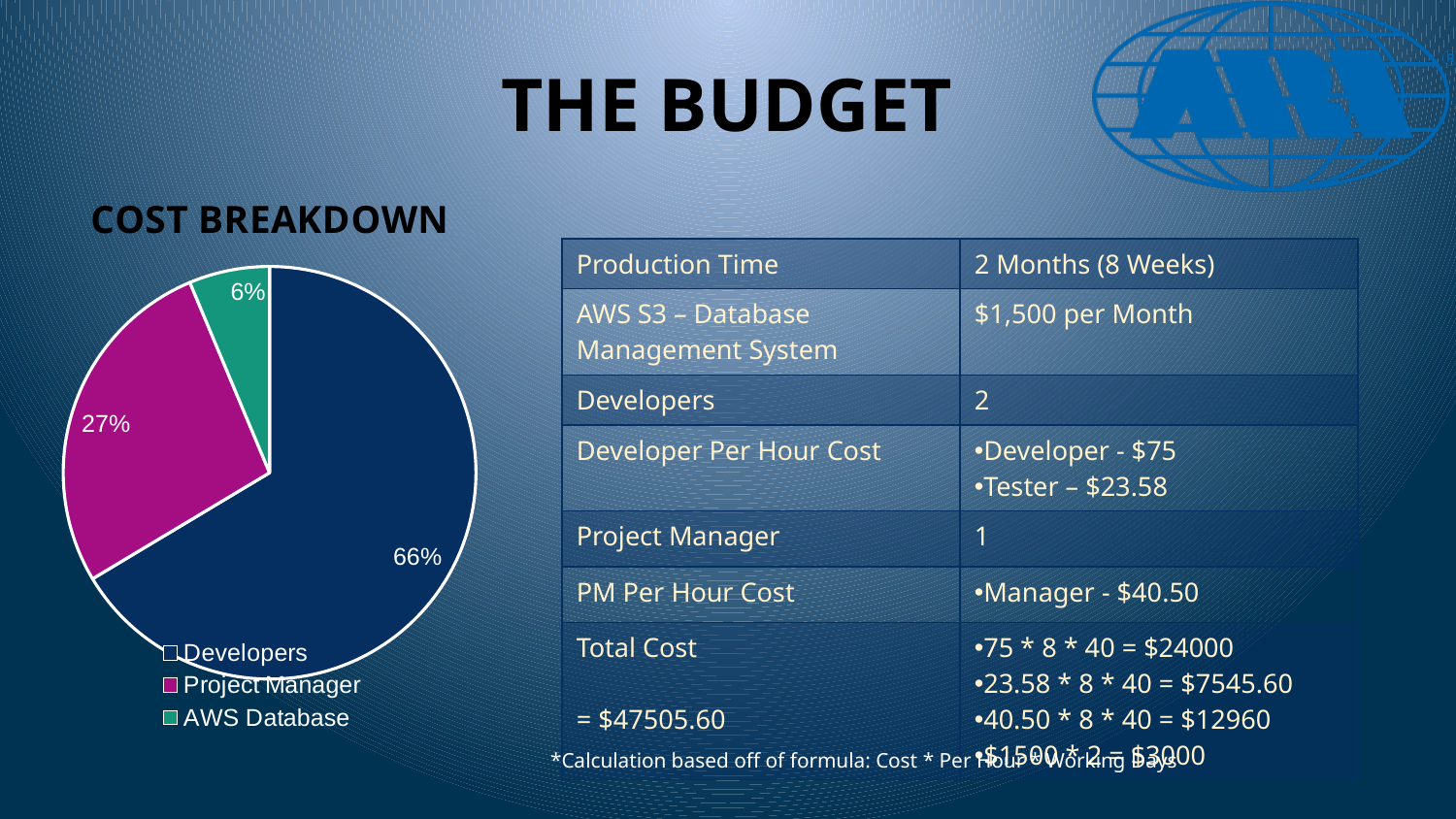
What is the title of the pie chart on the slide? COST BREAKDOWN How many entries does the legend of the cost breakdown pie chart list? 3 Which category has the smallest slice in the cost breakdown pie? AWS Database Which category has the largest slice in the cost breakdown pie? Developers In the cost breakdown pie, which is larger: Project Manager or AWS Database? Project Manager What is the difference in percentage points between the Developers slice and the Project Manager slice? 39 What is the difference in percentage points between the Project Manager slice and the AWS Database slice? 21 What type of chart is shown under "COST BREAKDOWN"? pie chart What share of the cost breakdown pie is Project Manager? 27% What share of the cost breakdown pie is AWS Database? 6% How many slices does the cost breakdown pie chart have? 3 What share of the cost breakdown pie is Developers? 66%